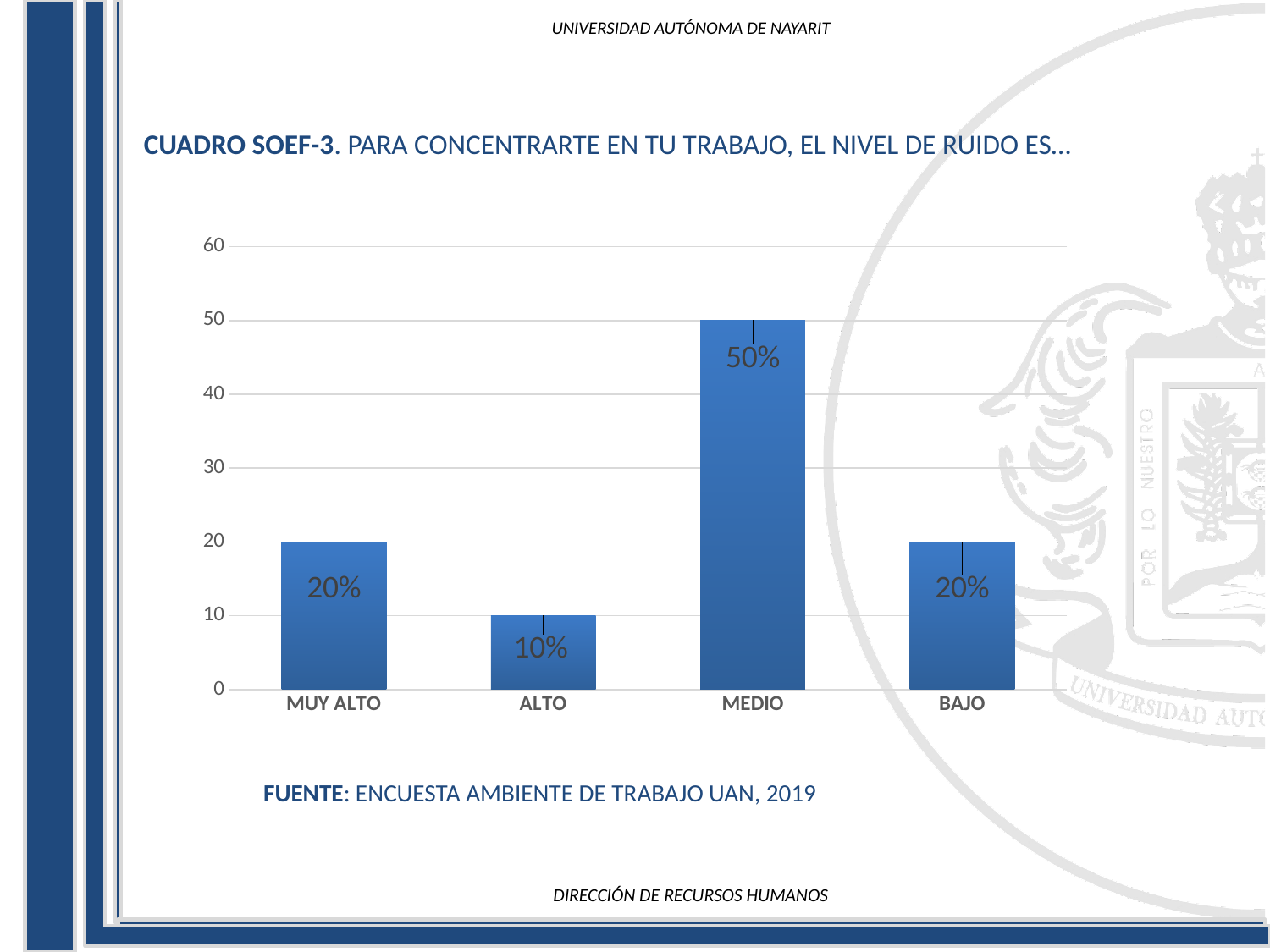
What is the difference between the values for MEDIO and ALTO? 40% Which category has the highest value? MEDIO How many categories are shown on the x axis? 4 What source is cited below the chart? ENCUESTA AMBIENTE DE TRABAJO UAN, 2019 What is the value for MUY ALTO? 20% What is the title of the chart? CUADRO SOEF-3. PARA CONCENTRARTE EN TU TRABAJO, EL NIVEL DE RUIDO ES… Which is larger, the value for MEDIO or the value for BAJO? MEDIO Is the value for MEDIO greater or less than 40? greater Which category has the lowest value? ALTO What kind of chart is shown on the slide? bar chart What is the value for MEDIO? 50% What is the value for ALTO? 10%